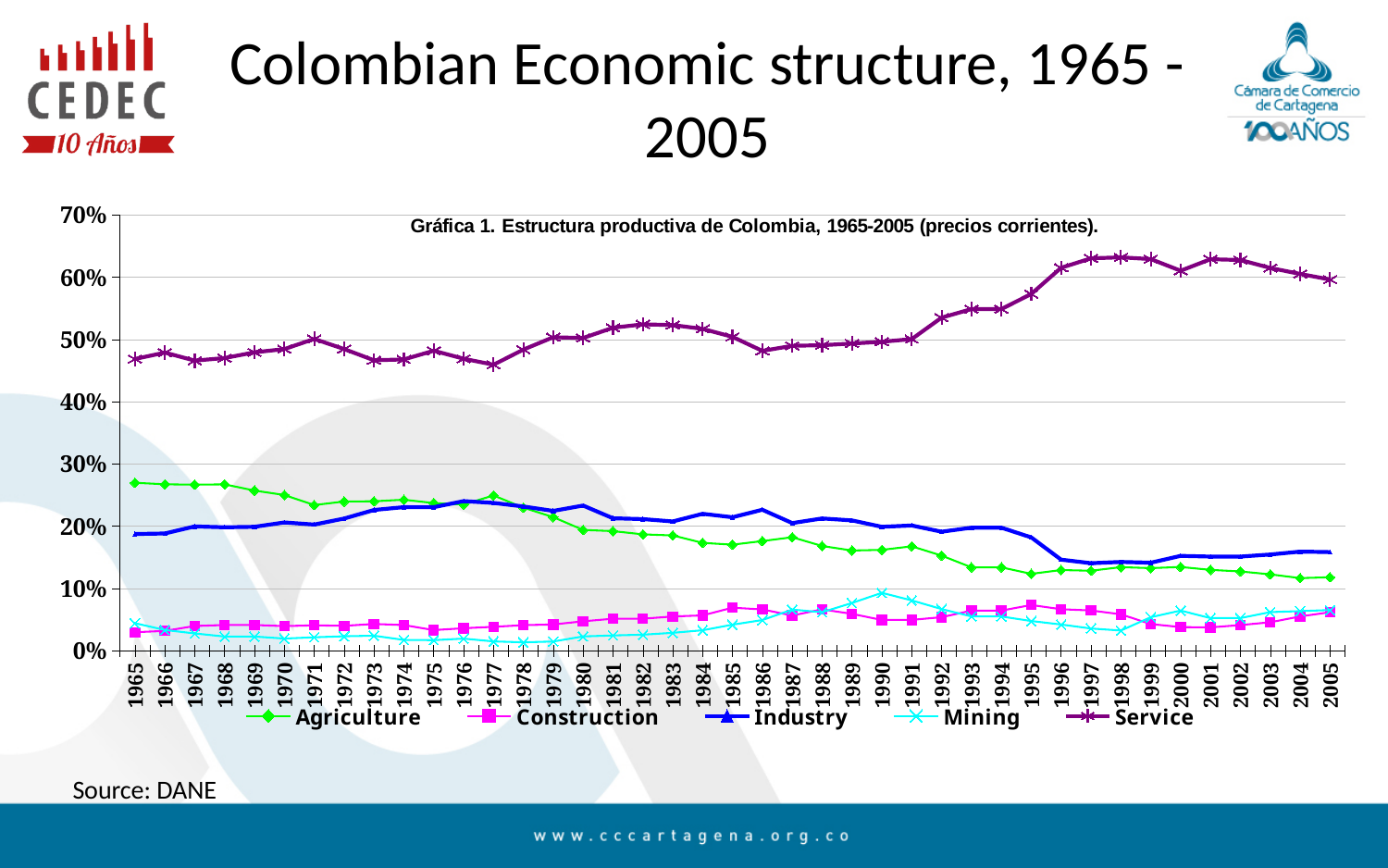
Which series has the highest value in 2005? Service How many years are plotted along the x axis? 41 Is the value for Industry in 2005 greater or less than 20%? less Which series has the lowest value in 1965? Construction Does the Agriculture series generally rise or fall from 1965 to 2005? Fall In 1965, which is larger: Agriculture or Industry? Agriculture What is the source cited below the chart? DANE How many series does the legend list? 5 Does the Service series generally rise or fall from 1965 to 2005? Rise What kind of chart is shown on the slide? Line chart In 2005, which is larger: Industry or Agriculture? Industry Is the value for Service in 2005 greater or less than 50%? greater